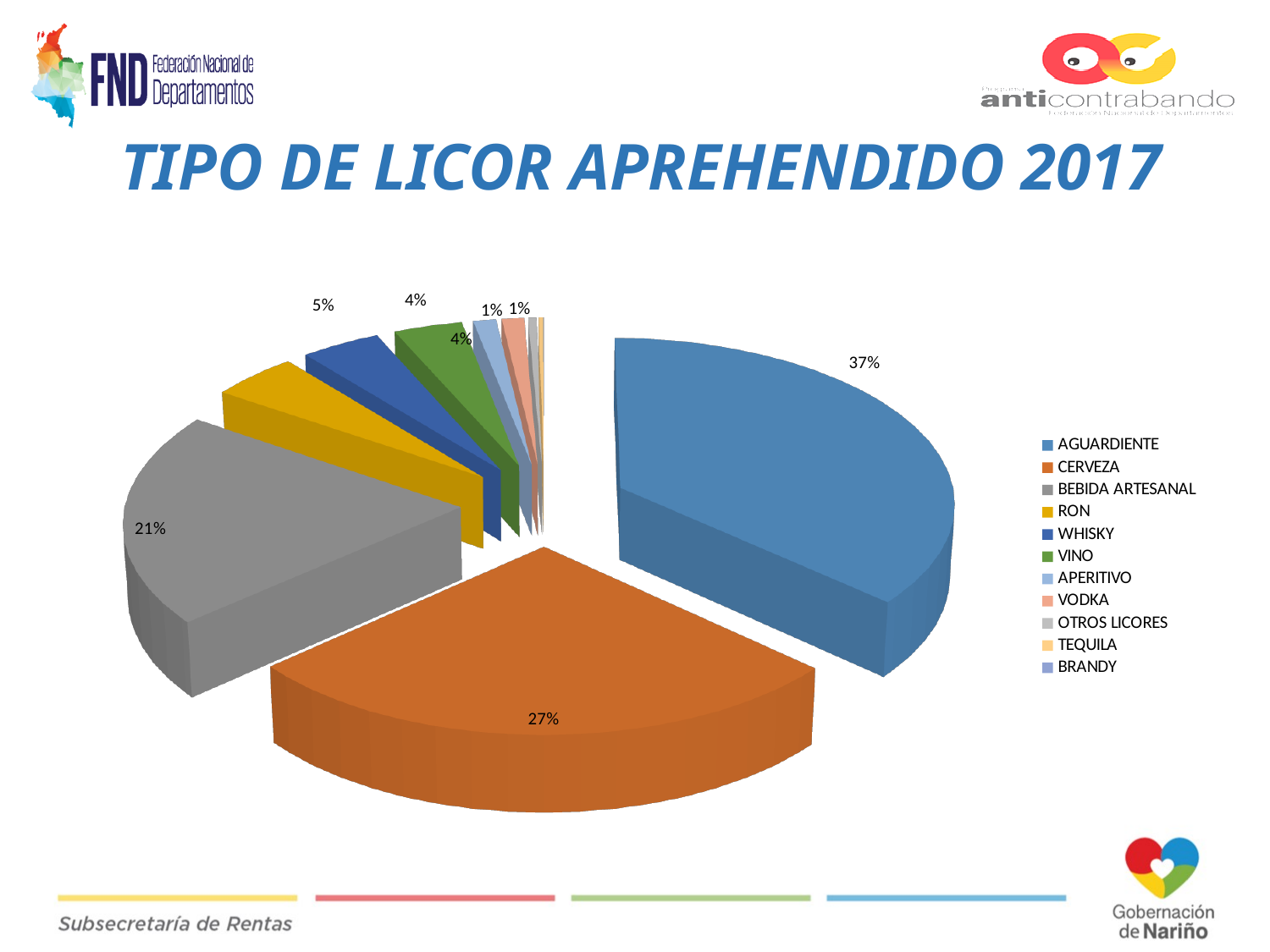
What share of the pie does AGUARDIENTE represent? 37% Which is larger, the share for CERVEZA or the share for BEBIDA ARTESANAL? CERVEZA What share of the pie does RON represent? 5% How many categories does the legend list? 11 How many percentage points larger is the AGUARDIENTE share than the CERVEZA share? 10 What share of the pie does BEBIDA ARTESANAL represent? 21% Which is larger, the share for RON or the share for WHISKY? RON How many percentage points larger is the AGUARDIENTE share than the BEBIDA ARTESANAL share? 16 What is the title of the chart? TIPO DE LICOR APREHENDIDO 2017 What kind of chart is shown on the slide? pie chart Which type of liquor has the largest slice of the pie? AGUARDIENTE